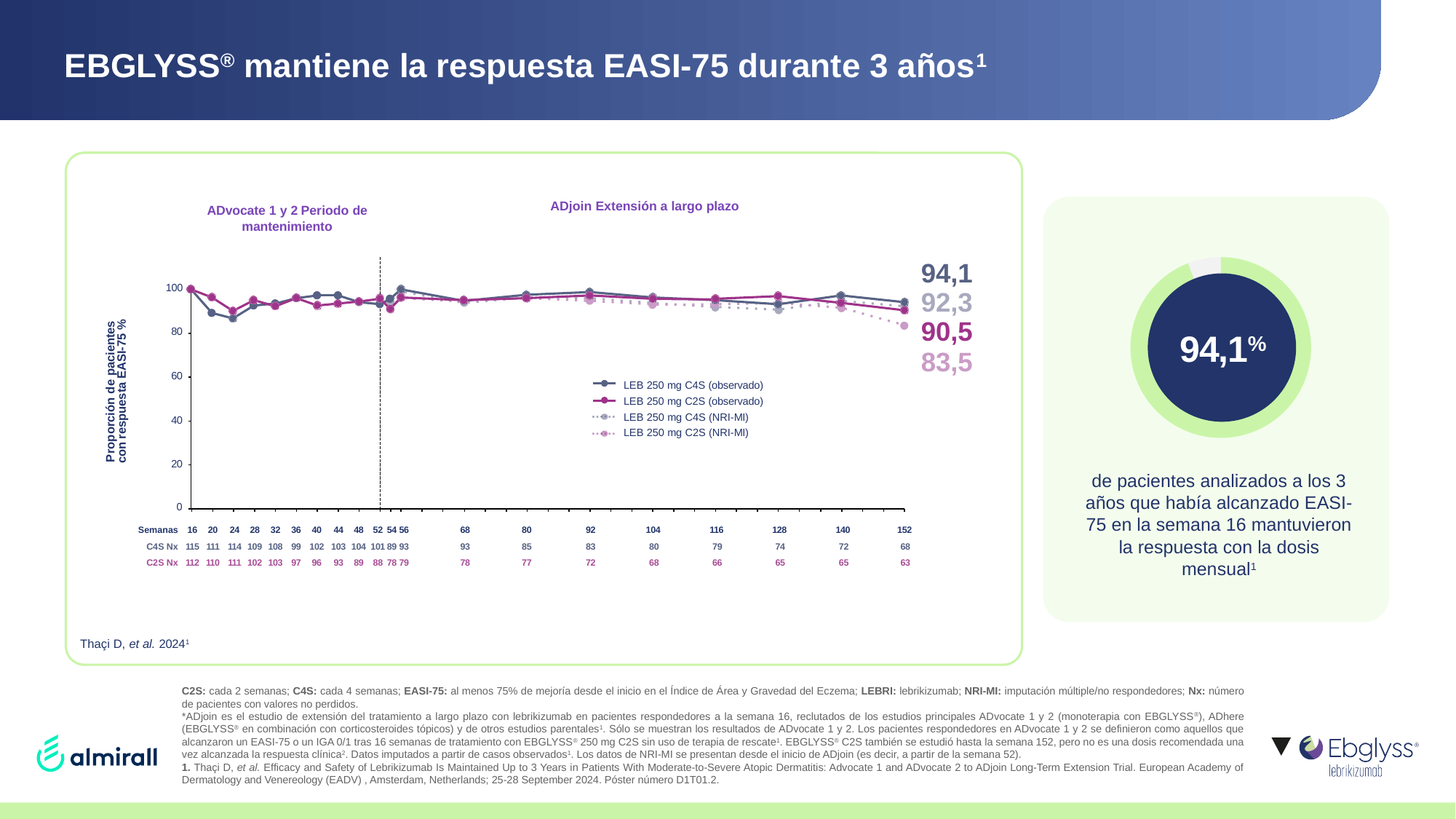
In the line chart, which series has the lowest value at week 152? LEB 250 mg C2S (NRI-MI) In the line chart, what is the difference between the week 152 values of LEB 250 mg C4S (observado) and LEB 250 mg C2S (NRI-MI)? 10,6 In the line chart, which series has the highest value at week 152? LEB 250 mg C4S (observado) How many series does the legend of the line chart list? 4 In the line chart, is the value for LEB 250 mg C2S (NRI-MI) at week 152 greater or less than 80? greater In the line chart, what is the value labelled at week 152 for LEB 250 mg C2S (NRI-MI)? 83,5 In the line chart, which is larger at week 152: LEB 250 mg C4S (NRI-MI) or LEB 250 mg C2S (observado)? LEB 250 mg C4S (NRI-MI) In the line chart, what is the value labelled at week 152 for LEB 250 mg C2S (observado)? 90,5 What percentage is shown in the centre of the donut chart on the right of the slide? 94,1% In the line chart, what is the value labelled at week 152 for LEB 250 mg C4S (observado)? 94,1 What kind of chart is the main chart on the left of the slide? line chart In the line chart's table below the x axis, what is the C4S Nx value at week 152? 68